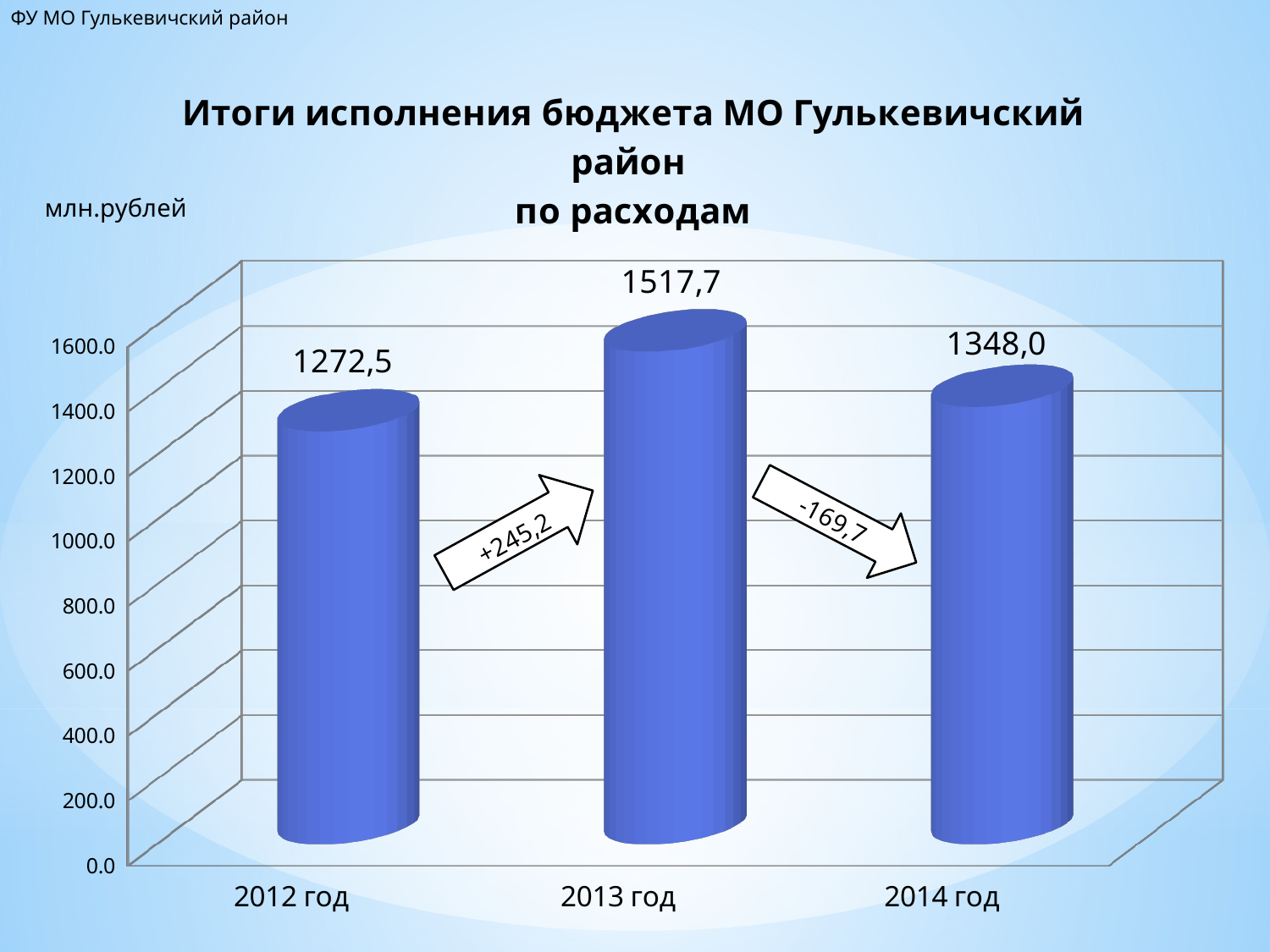
Is the value for 2013 год greater or less than 1400.0? greater How many years are shown on the chart? 3 Which is larger, the value for 2014 год or the value for 2012 год? 2014 год What is the value for 2012 год? 1272,5 Which year has the highest value? 2013 год What is the difference between the values for 2013 год and 2012 год? 245,2 Which year has the lowest value? 2012 год What is the difference between the values for 2013 год and 2014 год? 169,7 What unit is indicated for the values on the chart? млн.рублей What is the value for 2013 год? 1517,7 What is the value for 2014 год? 1348,0 What kind of chart is shown on the slide? bar chart